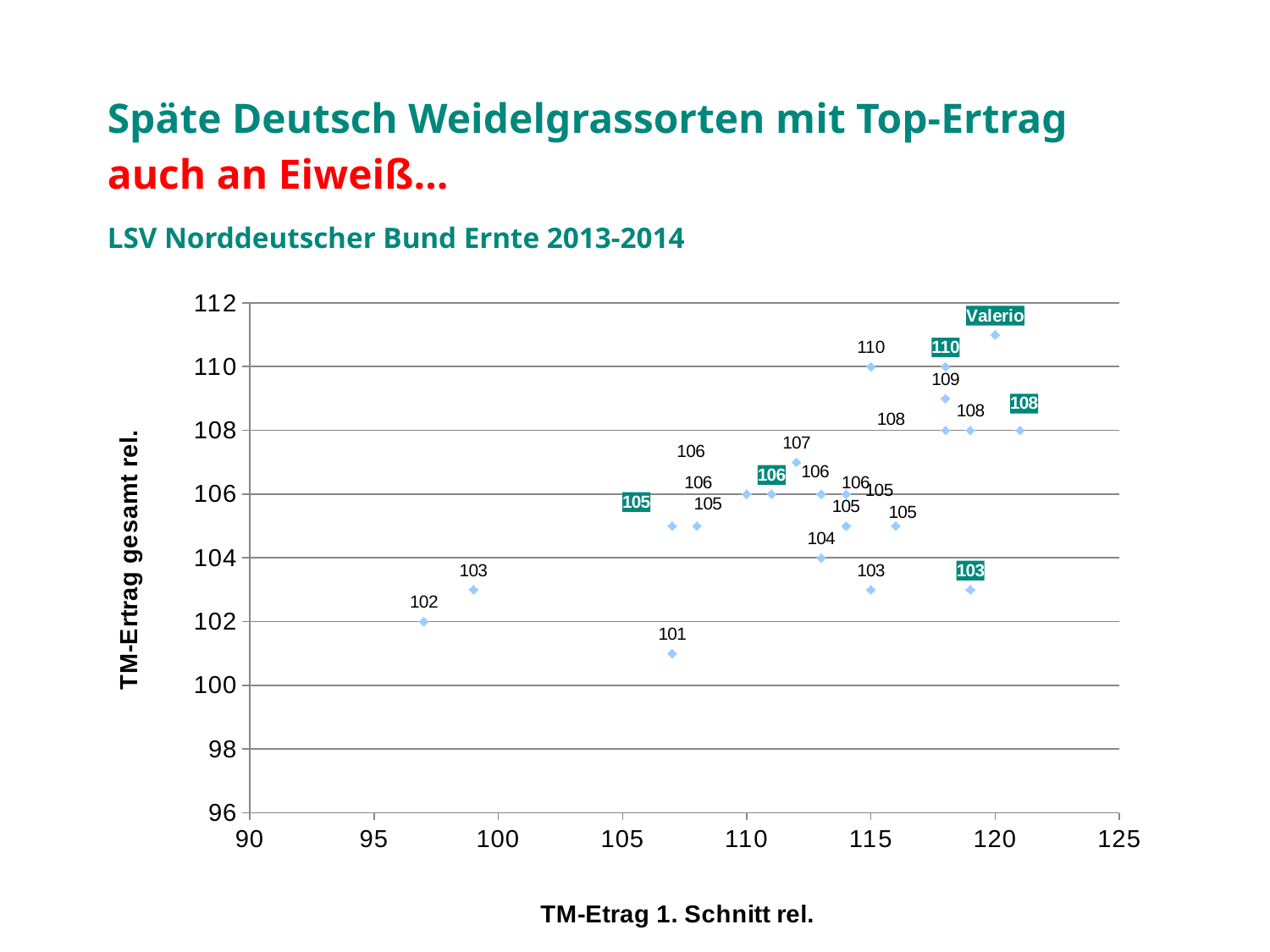
What is the TM-Ertrag gesamt rel. value of the point at TM-Etrag 1. Schnitt rel. 99? 103 What is the lowest TM-Ertrag gesamt rel. value printed as a data label on the chart? 101 Which point has the highest TM-Ertrag gesamt rel. value? Valerio Which variety is named on the chart? Valerio What is the title of the x axis of the chart? TM-Etrag 1. Schnitt rel. What kind of chart is shown on the slide? scatter chart What is the difference between the highest printed data label (110) and the lowest printed data label (101)? 9 Is the TM-Ertrag gesamt rel. value for Valerio greater or less than 110? greater Is the TM-Etrag 1. Schnitt rel. value for Valerio greater or less than 115? greater What is the title of the y axis of the chart? TM-Ertrag gesamt rel. What is the TM-Ertrag gesamt rel. value of the point with the lowest TM-Etrag 1. Schnitt rel. value (at 97)? 102 Do the TM-Ertrag gesamt rel. values generally rise or fall as TM-Etrag 1. Schnitt rel. increases? rise